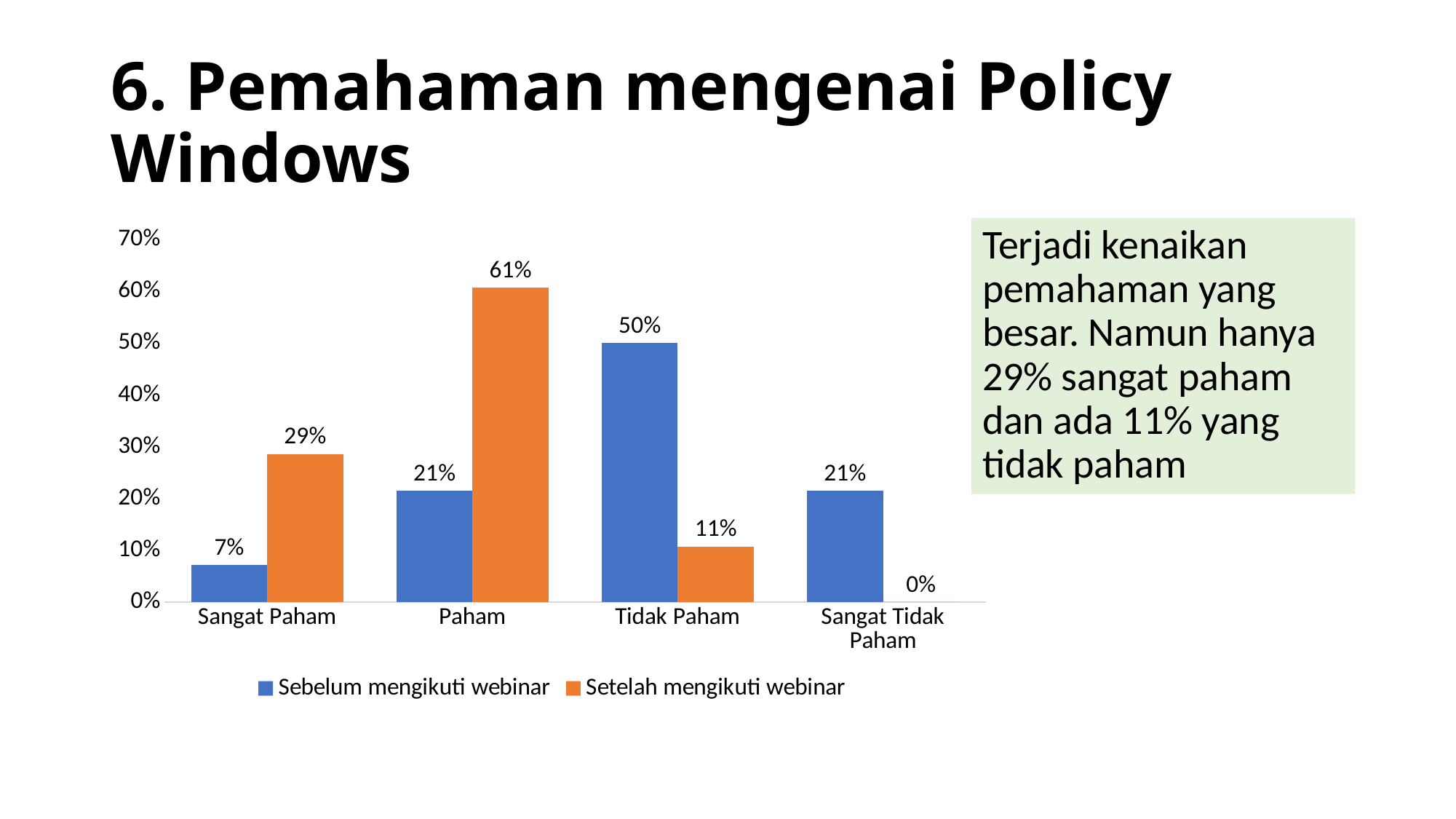
Which category has the highest value in the Setelah mengikuti webinar series? Paham What is the value for Sangat Paham in the Sebelum mengikuti webinar series? 7% What is the value for Paham in the Setelah mengikuti webinar series? 61% What is the value for Tidak Paham in the Sebelum mengikuti webinar series? 50% What kind of chart is shown on the slide? Bar chart For Tidak Paham, which series has the larger value: Sebelum mengikuti webinar or Setelah mengikuti webinar? Sebelum mengikuti webinar How many series does the legend list? 2 What is the value for Sangat Tidak Paham in the Setelah mengikuti webinar series? 0% What colour are the bars for the Setelah mengikuti webinar series? Orange Which category has the lowest value in the Sebelum mengikuti webinar series? Sangat Paham How many categories are shown on the x axis? 4 What is the difference between the Setelah mengikuti webinar and Sebelum mengikuti webinar values for Paham? 40%